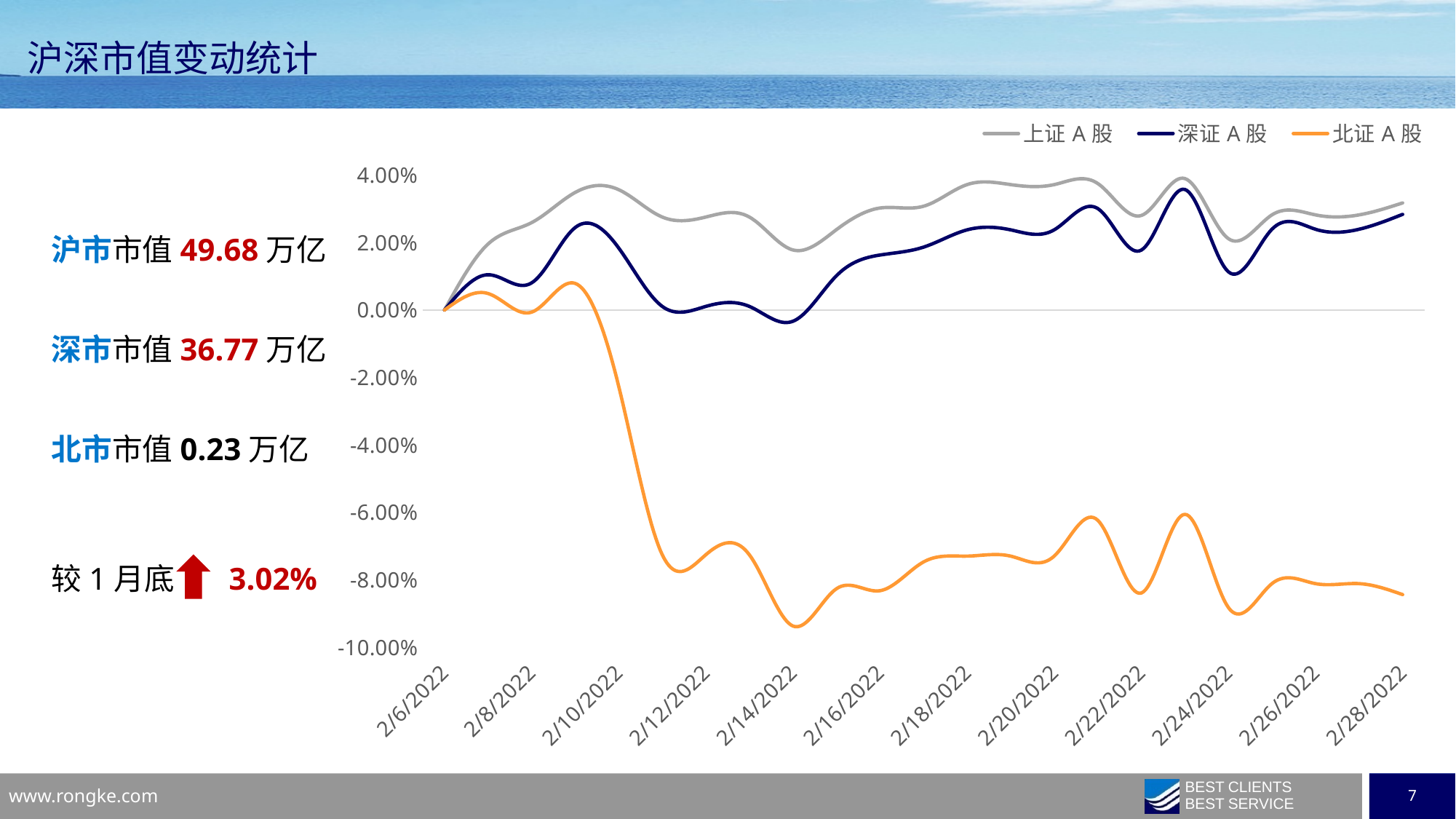
How many series does the chart legend list? 3 Does the 北证 A 股 line rise or fall between 2/10/2022 and 2/12/2022? fall How many date labels are shown on the x axis? 12 Is the value for 北证 A 股 on 2/28/2022 greater or less than -6.00%? less Is the value for 深证 A 股 on 2/24/2022 greater or less than 2.00%? less Is the value for 上证 A 股 on 2/10/2022 greater or less than 2.00%? greater What kind of chart is shown on the slide? line chart What is the title of the slide containing the chart? 沪深市值变动统计 On 2/14/2022, which series has the higher value, 上证 A 股 or 深证 A 股? 上证 A 股 Which series has the lowest value on 2/28/2022? 北证 A 股 Which series does the orange line represent? 北证 A 股